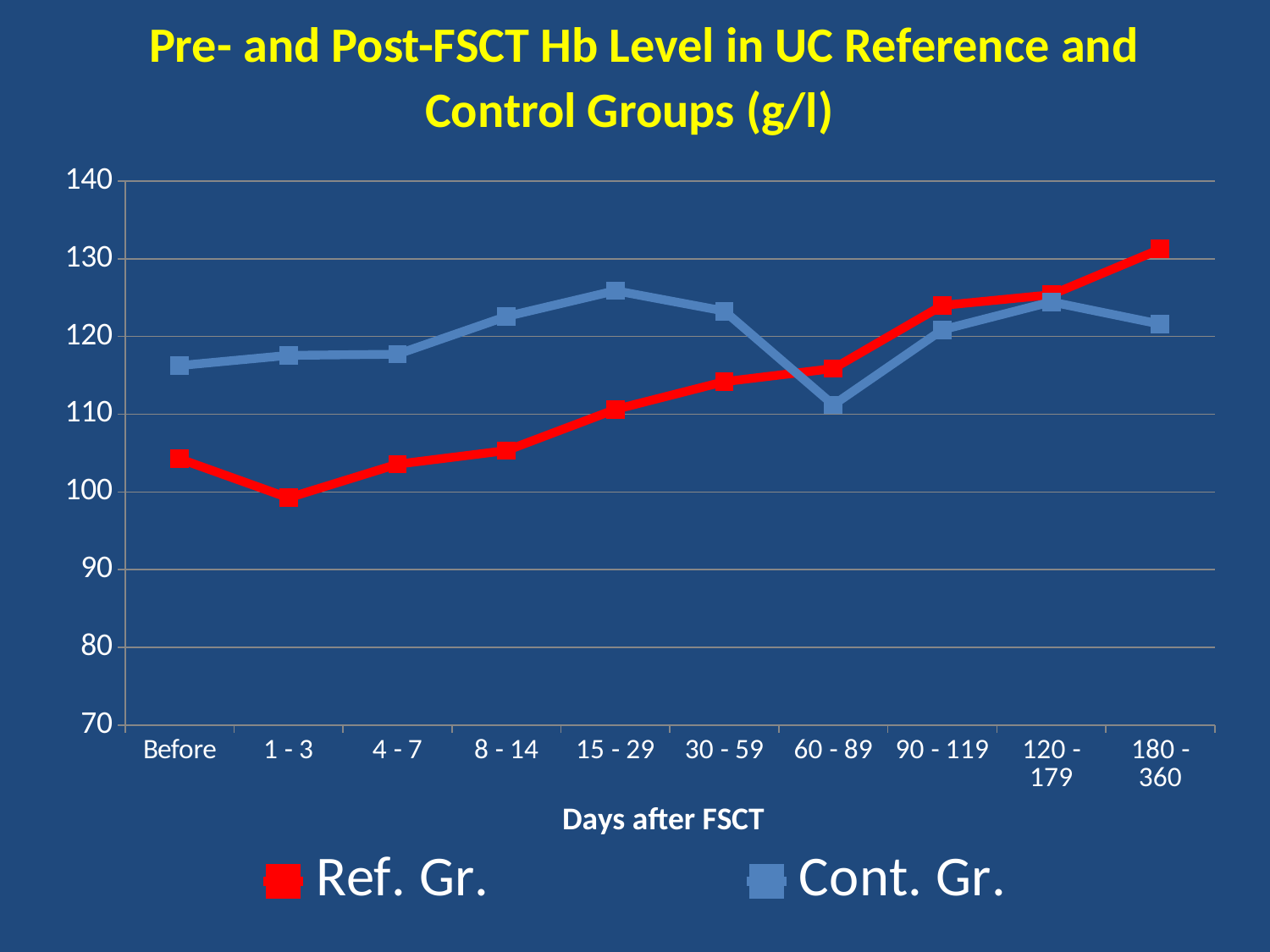
How many series does the legend list? 2 How many time-point categories are shown along the x axis? 10 Is the Ref. Gr. value at 180 - 360 greater or less than 120? greater Is the Cont. Gr. value at 60 - 89 greater or less than 120? less At 180 - 360 days, which group has the higher Hb level, Ref. Gr. or Cont. Gr.? Ref. Gr. What kind of chart is shown on the slide? line chart At which time point does the Cont. Gr. line reach its lowest value? 60 - 89 At which time point does the Cont. Gr. line reach its highest value? 15 - 29 Is the Ref. Gr. value at Before greater or less than 110? less At which time point does the Ref. Gr. line reach its highest value? 180 - 360 At which time point does the Ref. Gr. line reach its lowest value? 1 - 3 At the Before time point, which group has the higher Hb level, Ref. Gr. or Cont. Gr.? Cont. Gr.